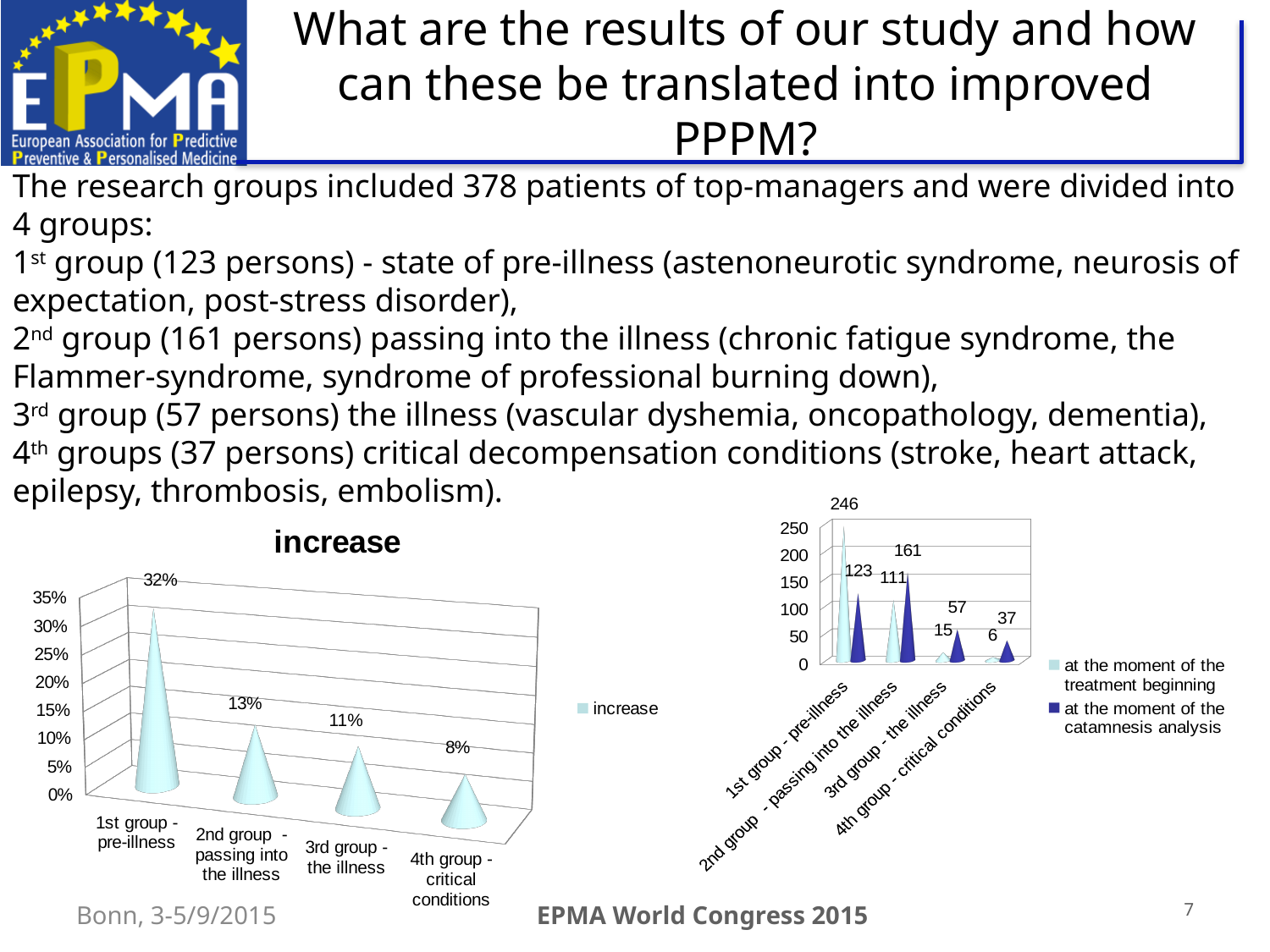
In the 'increase' chart, how many groups are plotted? 4 In the 'increase' chart, which group has the highest value? 1st group - pre-illness In the 'increase' chart, what is the value for the 1st group - pre-illness? 32% In the chart on the right, which group has the lowest value at the moment of the treatment beginning? 4th group - critical conditions In the 'increase' chart, what is the difference between the 1st group and the 2nd group values? 19% What is the title of the chart on the left? increase In the chart on the right, what is the value for the 3rd group - the illness at the moment of the catamnesis analysis? 57 In the chart on the right, what is the value for the 1st group - pre-illness at the moment of the treatment beginning? 246 In the chart on the right, for the 2nd group - passing into the illness, which is larger: the value at the moment of the treatment beginning or at the moment of the catamnesis analysis? at the moment of the catamnesis analysis In the 'increase' chart, what is the value for the 4th group - critical conditions? 8% How many series does the legend of the chart on the right list? 2 In the 'increase' chart, do the values rise or fall from the 1st group to the 4th group? fall